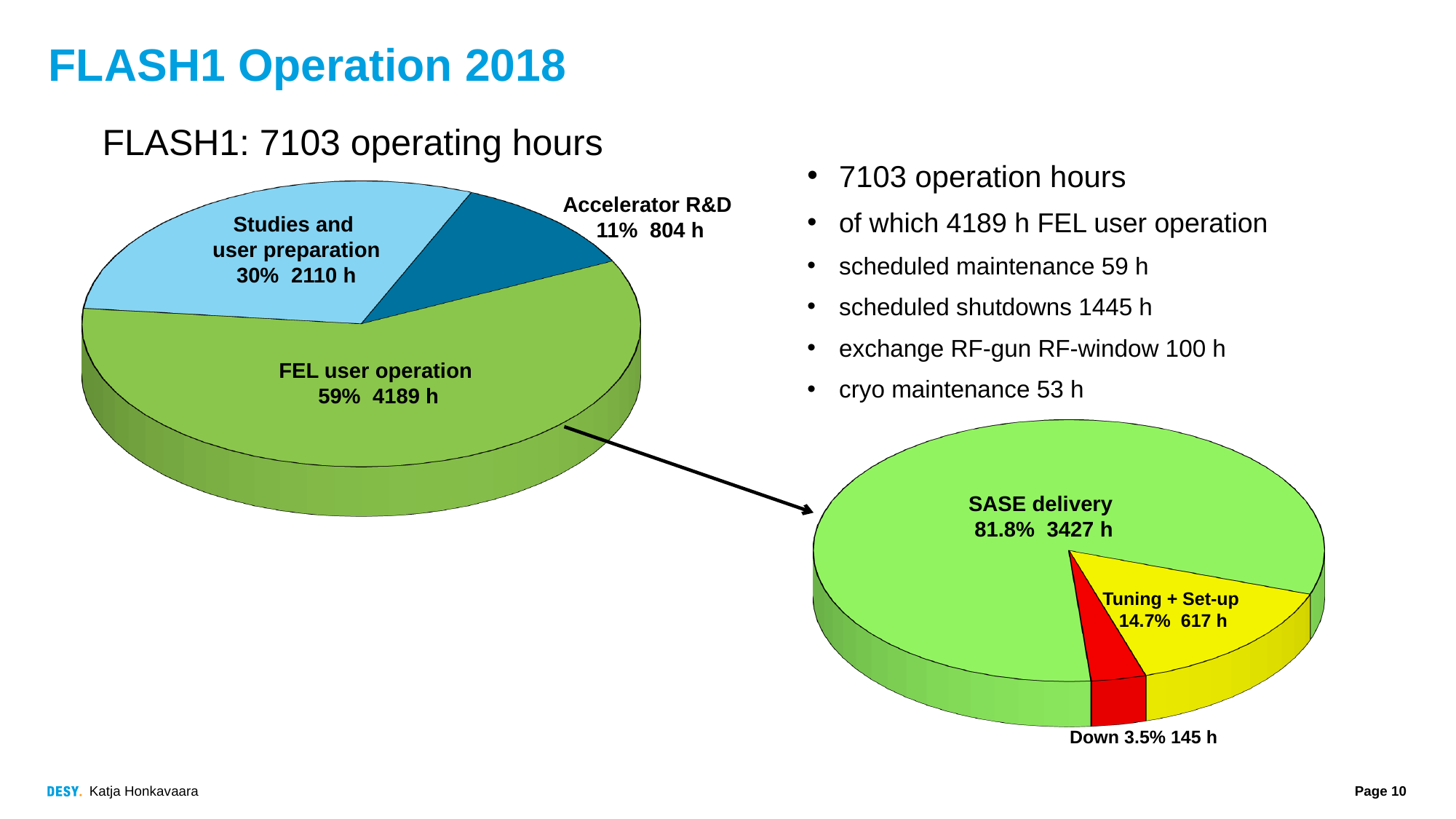
On the left pie chart (FLASH1: 7103 operating hours), how many hours are shown for Accelerator R&D? 804 h On the right pie chart (the FEL user operation breakdown), how many hours are shown for Tuning + Set-up? 617 h On the left pie chart (FLASH1: 7103 operating hours), what is the difference in hours between FEL user operation and Studies and user preparation? 2079 h On the right pie chart (the FEL user operation breakdown), which is larger: Tuning + Set-up or Down? Tuning + Set-up On the left pie chart (FLASH1: 7103 operating hours), which slice is the smallest? Accelerator R&D On the left pie chart (FLASH1: 7103 operating hours), how many hours are shown for FEL user operation? 4189 h What type of chart is used on the right side of the slide to show the FEL user operation breakdown? Pie chart On the left pie chart (FLASH1: 7103 operating hours), how many slices does the pie have? 3 On the right pie chart (the FEL user operation breakdown), which slice is the smallest? Down On the left pie chart (FLASH1: 7103 operating hours), which slice is the largest? FEL user operation On the left pie chart (FLASH1: 7103 operating hours), what percentage share does Studies and user preparation have? 30% On the right pie chart (the FEL user operation breakdown), what percentage share does SASE delivery have? 81.8%